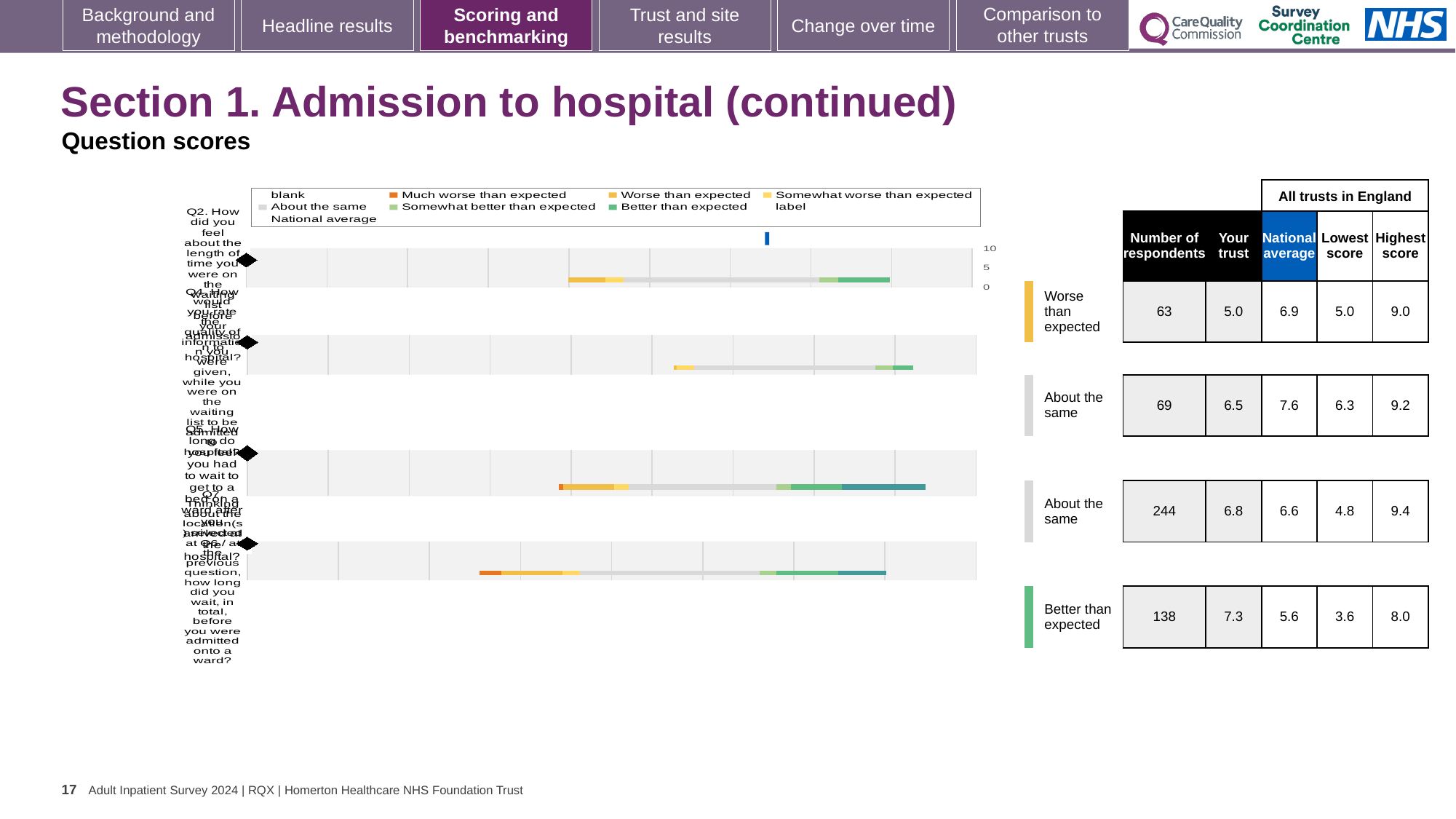
In the table beside the chart, how many respondents are listed for the last row (rated 'Better than expected')? 138 In the table beside the chart, what is the 'Your trust' score for the first row (rated 'Worse than expected')? 5.0 For the last row (rated 'Better than expected'), what is the difference between the highest score and the lowest score? 4.4 What is the highest score listed for the second row of the table beside the chart? 9.2 What kind of chart is shown on the slide? bar chart Which row in the table beside the chart has the highest number of respondents? the third row (244) What is the lowest score listed for the third row of the table beside the chart? 4.8 What rating label is shown next to the fourth (bottom) row of the chart? Better than expected How many question rows are plotted in the chart? 4 For the first row (rated 'Worse than expected'), what is the difference between the national average and the 'Your trust' score? 1.9 For the last row (rated 'Better than expected'), which is larger: the 'Your trust' score or the national average? Your trust (7.3) Which row in the table beside the chart has the lowest 'Your trust' score? the first row (5.0)